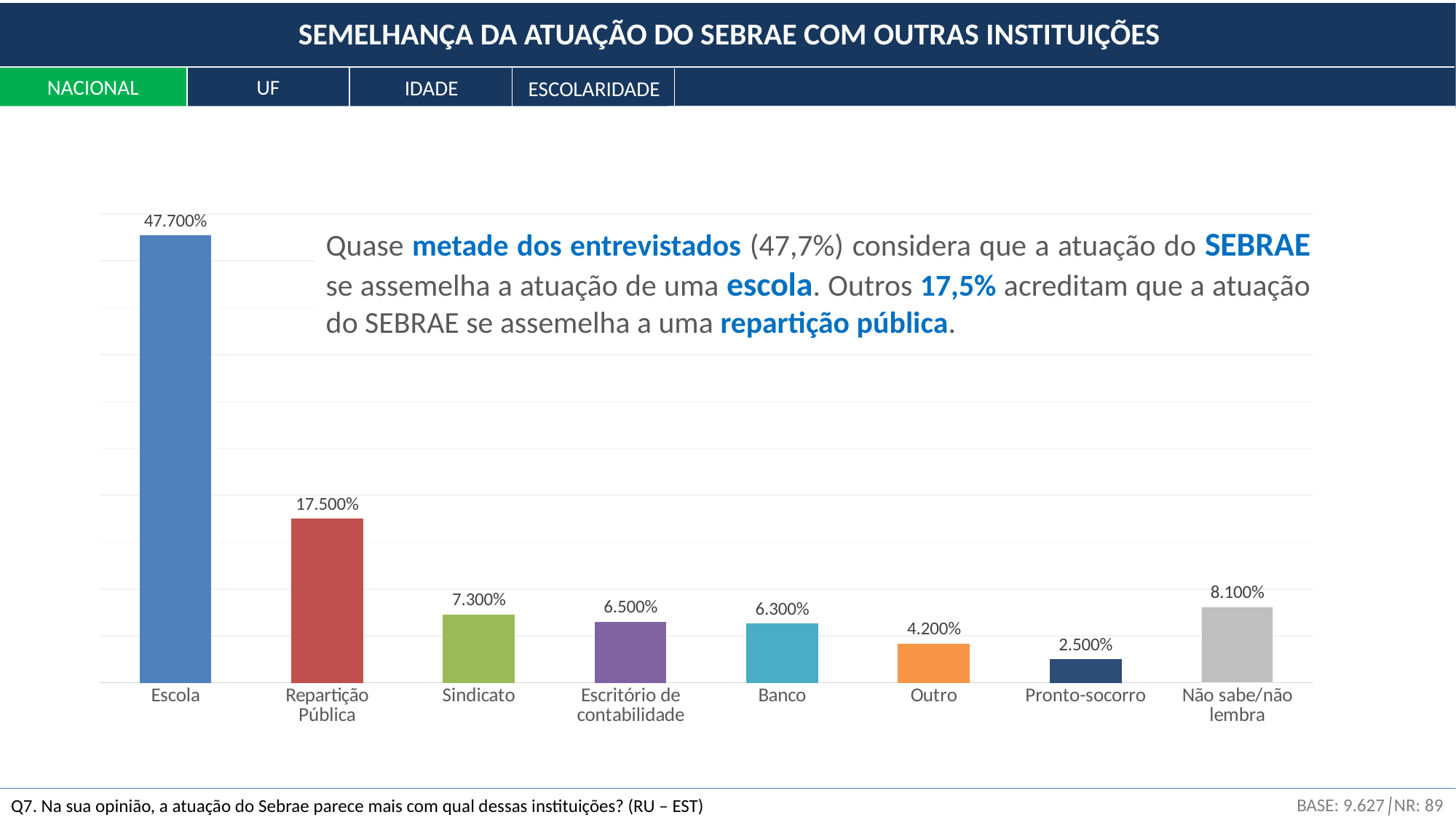
What is the value for Banco? 6.300% Which is larger, the value for Sindicato or the value for Outro? Sindicato Which category has the lowest value? Pronto-socorro What colour is the bar for Outro? Orange What is the difference between the values for Escola and Repartição Pública? 30.200% What kind of chart is shown on the slide? Bar chart What is the difference between the values for Não sabe/não lembra and Pronto-socorro? 5.600% What is the value for Não sabe/não lembra? 8.100% Which category has the highest value? Escola What is the value for Escola? 47.700% What is the value for Repartição Pública? 17.500% How many categories are shown on the x axis? 8